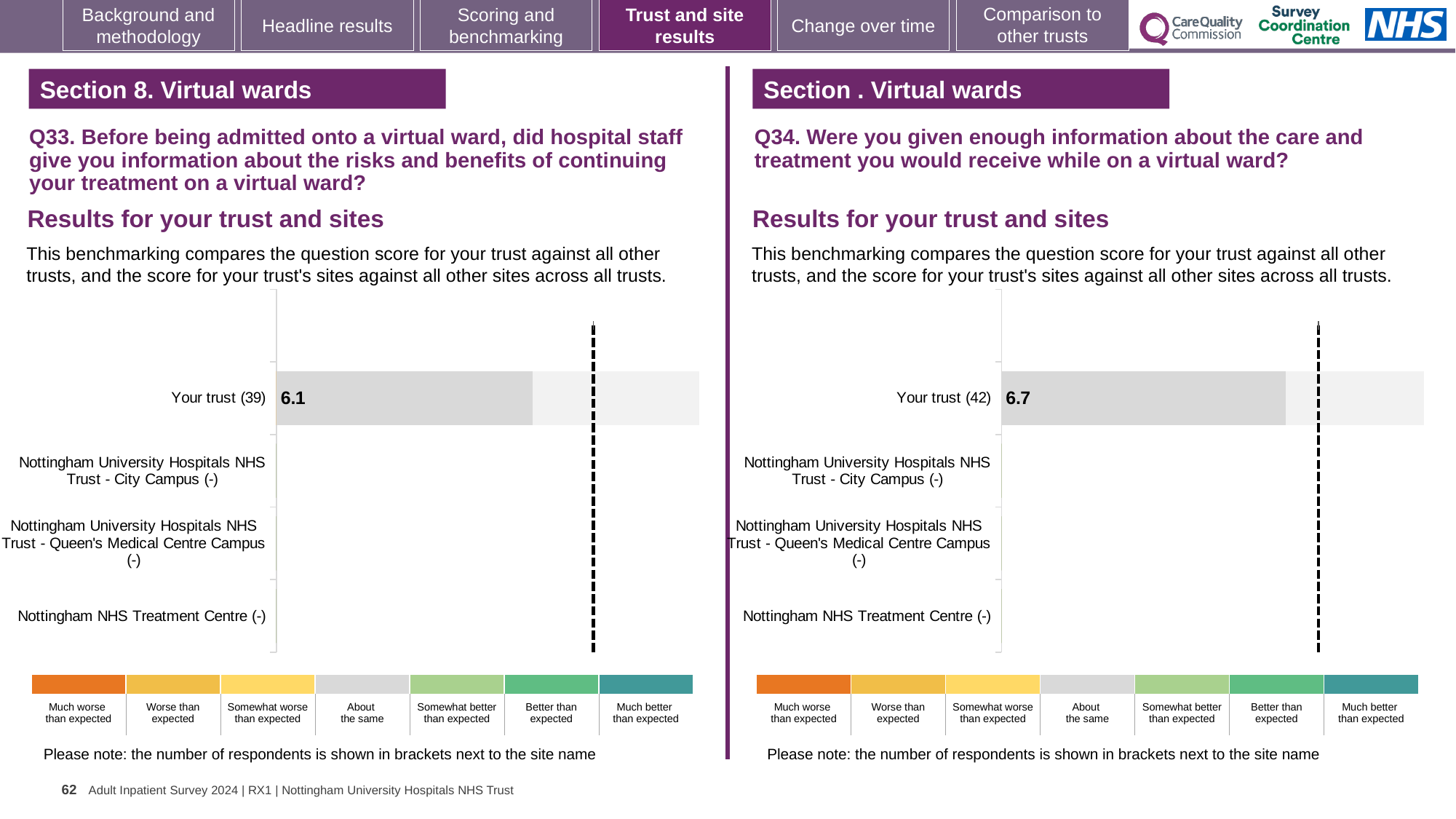
Which chart shows a higher score for Your trust, the left chart (Q33) or the right chart (Q34)? the right chart (Q34) On the left chart (Q33), how many categories are listed on the vertical axis? 4 On the left chart (Q33), how many categories have a plotted bar? 1 What is the difference between the Your trust score on the right chart (Q34) and the Your trust score on the left chart (Q33)? 0.6 On the left chart (Q33), what is the score for Your trust? 6.1 On the right chart (Q34), what is the score for Your trust? 6.7 On the right chart (Q34), how many categories are shown in the colour key below the chart? 7 On the right chart (Q34), how many respondents are shown in brackets next to Your trust? 42 On the left chart (Q33), what is the label of the last category on the vertical axis? Nottingham NHS Treatment Centre (-) On the left chart (Q33), how many respondents are shown in brackets next to Your trust? 39 On the right chart (Q34), how many categories are listed on the vertical axis? 4 What kind of chart is the left chart (Q33)? bar chart